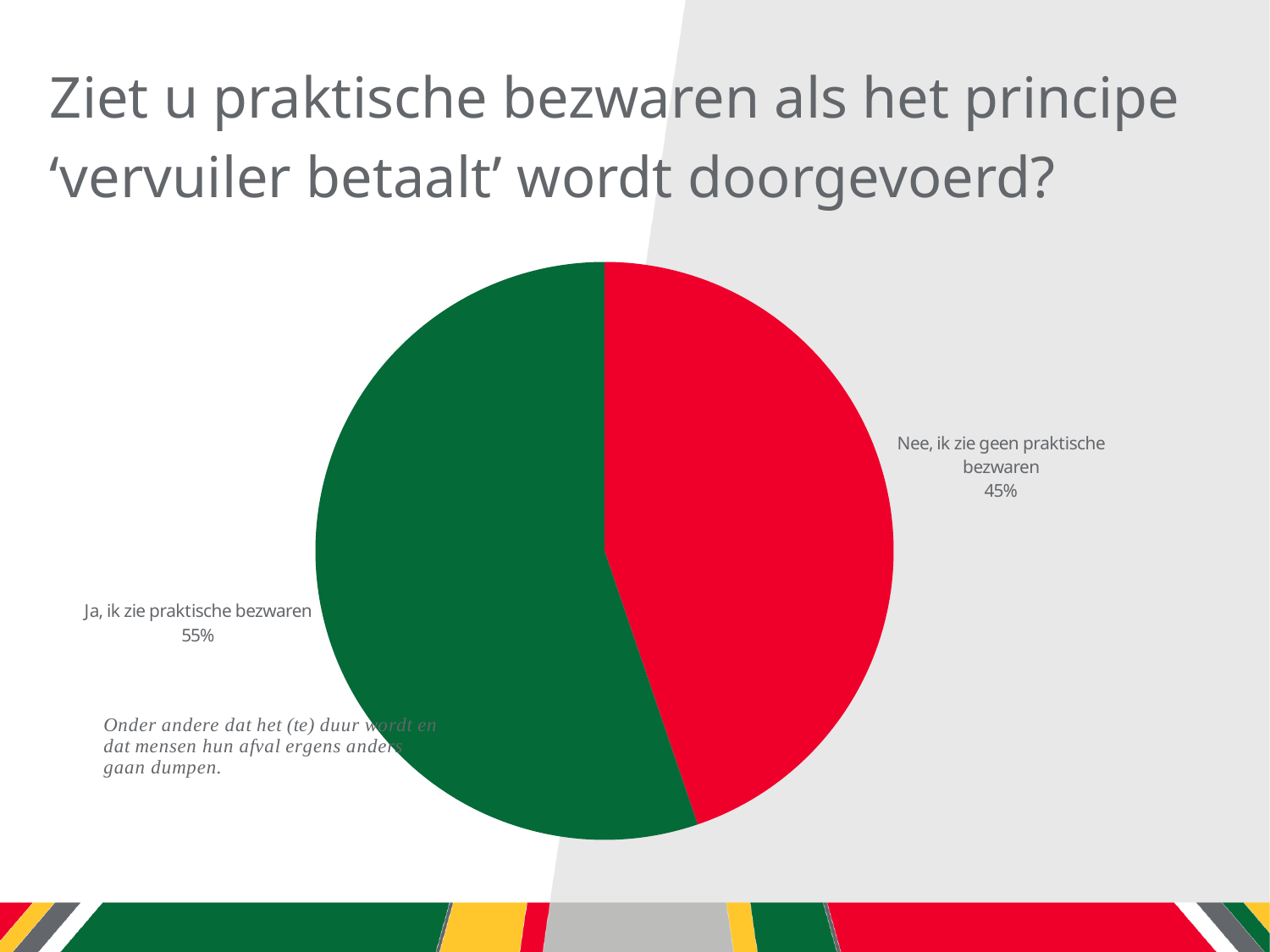
What colour is the slice for 'Nee, ik zie geen praktische bezwaren'? Red Which answer has the largest share of the pie? Ja, ik zie praktische bezwaren What is the difference in percentage points between the 'Ja' and 'Nee' slices? 10 percentage points What share of respondents answered 'Ja, ik zie praktische bezwaren'? 55% How many slices does the pie chart have? 2 Which is larger: the share for 'Ja, ik zie praktische bezwaren' or for 'Nee, ik zie geen praktische bezwaren'? Ja, ik zie praktische bezwaren Which answer has the smallest share of the pie? Nee, ik zie geen praktische bezwaren What share of respondents answered 'Nee, ik zie geen praktische bezwaren'? 45% Is the share for 'Nee, ik zie geen praktische bezwaren' greater or less than 50%? less What colour is the slice for 'Ja, ik zie praktische bezwaren'? Green What kind of chart is shown on the slide? Pie chart